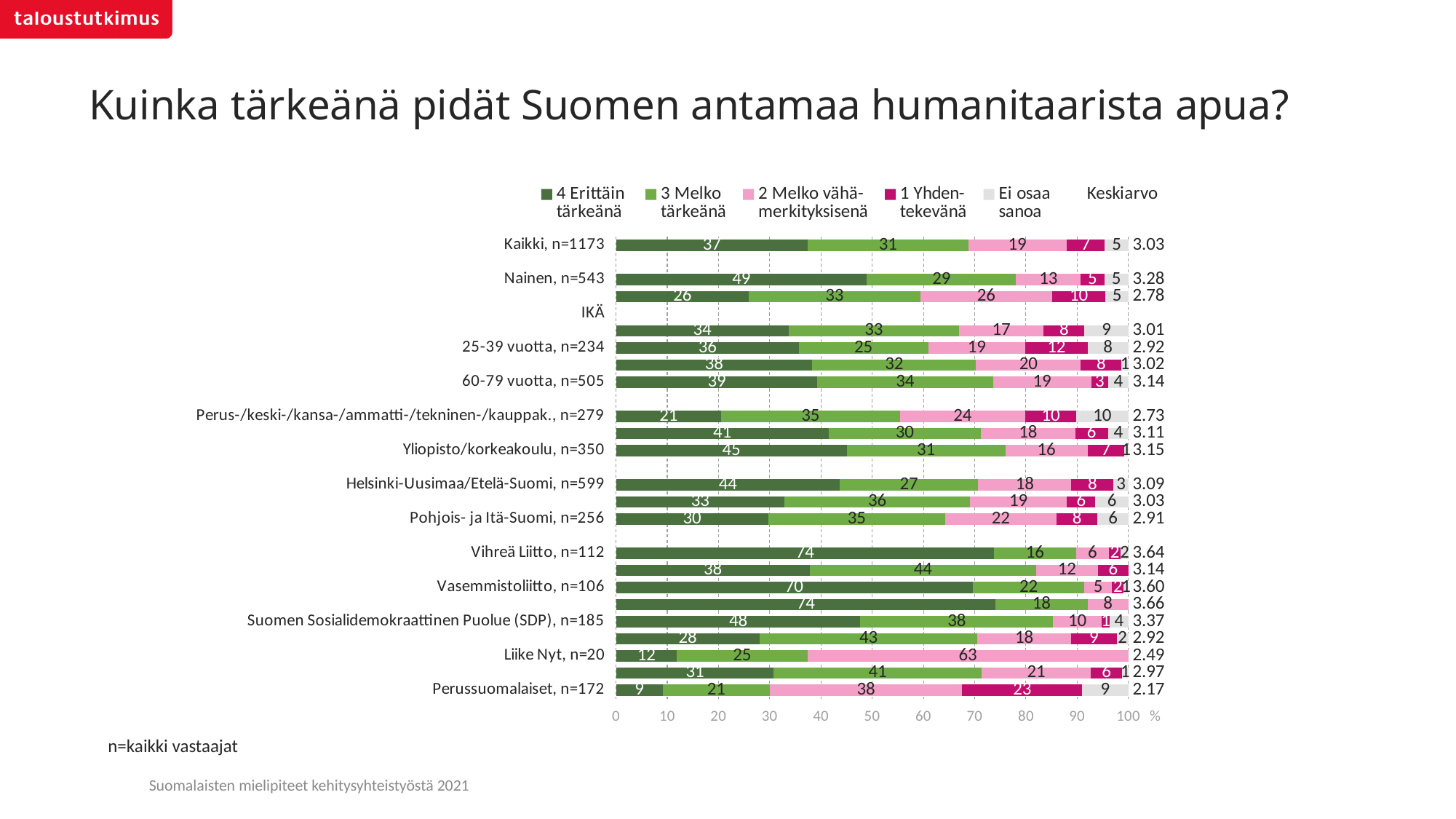
What kind of chart is shown on the slide? Stacked bar chart What percentage of Perussuomalaiset, n=172 answered "1 Yhdentekevänä"? 23 What percentage of Liike Nyt, n=20 answered "2 Melko vähämerkityksisenä"? 63 What is the Keskiarvo value for Vihreä Liitto, n=112? 3.64 Which labelled group has the lowest Keskiarvo value? Perussuomalaiset, n=172 What is the Keskiarvo value for Nainen, n=543? 3.28 What percentage of Yliopisto/korkeakoulu, n=350 answered "3 Melko tärkeänä"? 31 What colour represents "4 Erittäin tärkeänä" in the legend? Dark green What is the difference in the "4 Erittäin tärkeänä" share between Vihreä Liitto, n=112 and Perussuomalaiset, n=172? 65 How many series does the legend list (excluding the Keskiarvo column)? 5 What percentage of Kaikki, n=1173 answered "4 Erittäin tärkeänä"? 37 Which has a larger share of "4 Erittäin tärkeänä": Nainen, n=543 or Kaikki, n=1173? Nainen, n=543